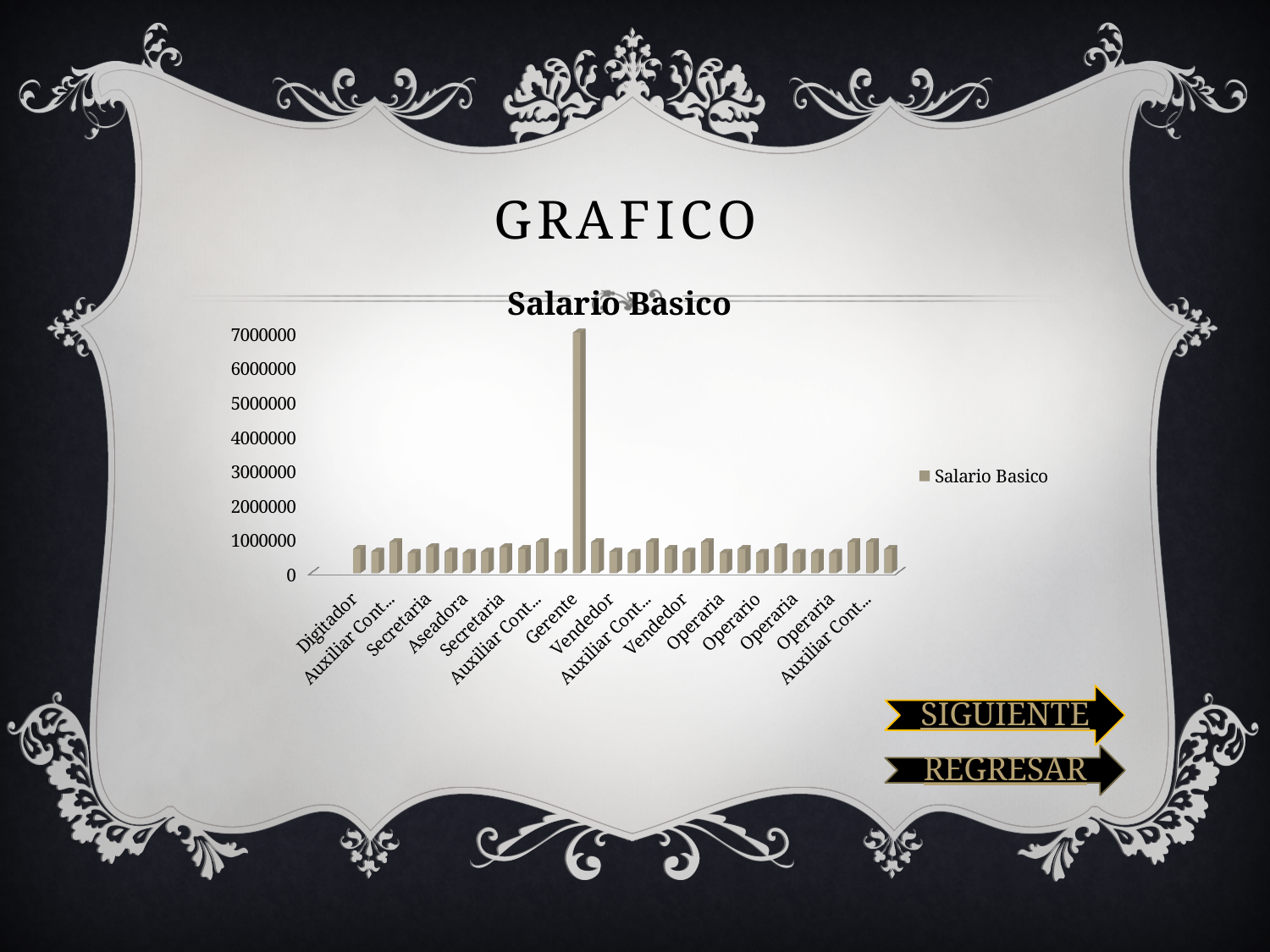
What series name appears in the legend? Salario Basico Is the value for Aseadora greater or less than 1000000? less Which is larger, the value for Gerente or the value for Digitador? Gerente Is the value for Digitador greater or less than 1000000? less How many series does the legend list? 1 Is the value for Gerente greater or less than 3000000? greater Which category has the highest Salario Basico? Gerente What kind of chart is shown on the slide? bar chart What is the highest value shown on the vertical axis? 7000000 Which is larger, the value for Gerente or the value for Aseadora? Gerente What is the title of the chart? Salario Basico